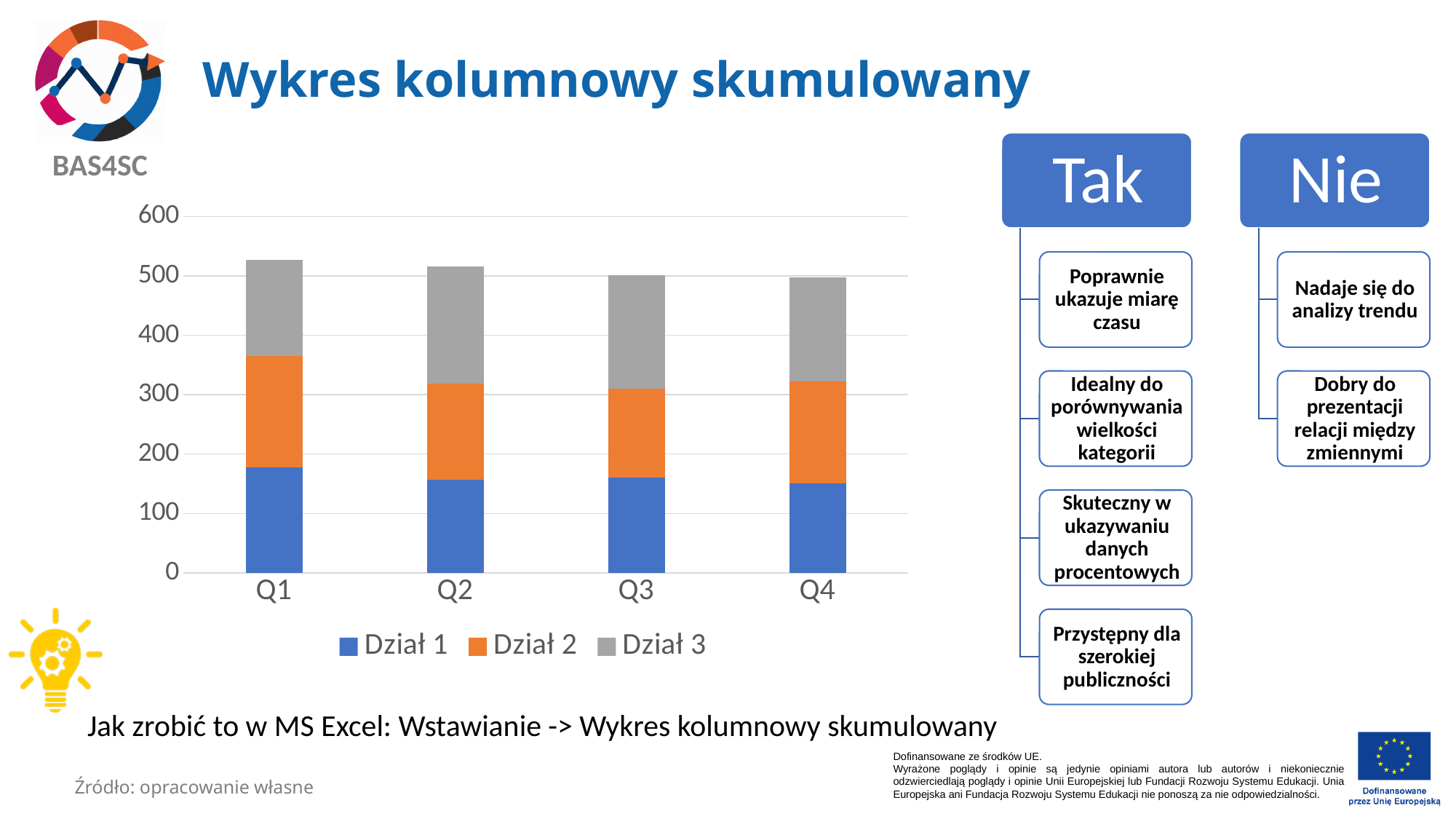
Is the value for Dział 1 in Q4 greater or less than 200? less What kind of chart is shown on the slide? bar chart How many series does the chart legend list? 3 What is the title of the slide containing the chart? Wykres kolumnowy skumulowany Is the total stacked bar for Q1 greater or less than 500? greater Which quarter has the highest total stacked bar? Q1 What are the series names listed in the chart legend? Dział 1, Dział 2, Dział 3 Do the total stacked bar heights generally rise or fall from Q1 to Q4? fall Is the value for Dział 1 in Q1 greater or less than 200? less How many categories are shown on the x axis of the chart? 4 Is the total stacked bar for Q1 larger or smaller than the total stacked bar for Q4? larger